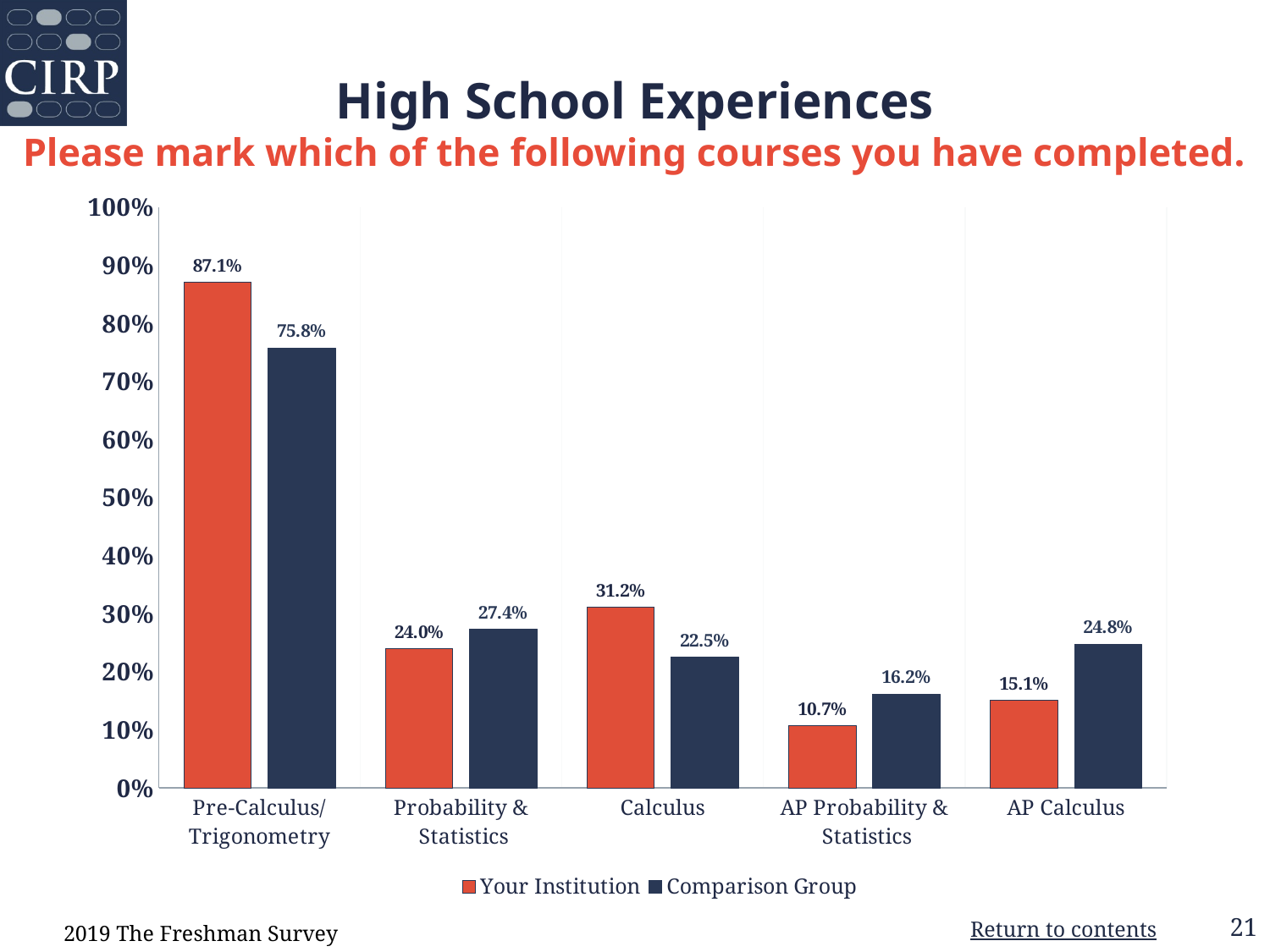
What kind of chart is shown on the slide? Bar chart How many series does the legend list? 2 How many courses are shown on the x axis? 5 What is the Comparison Group value for AP Calculus? 24.8% For Probability & Statistics, which is larger: Your Institution or the Comparison Group? Comparison Group Which course has the highest Your Institution value? Pre-Calculus/Trigonometry What is the Your Institution value for AP Probability & Statistics? 10.7% Which course has the lowest Comparison Group value? AP Probability & Statistics What is the difference between Your Institution and the Comparison Group for Calculus? 8.7% Is the Your Institution value for Calculus greater or less than 30%? greater What percentage of Your Institution students completed Pre-Calculus/Trigonometry? 87.1% What is the difference between the Comparison Group and Your Institution for Pre-Calculus/Trigonometry? 11.3%